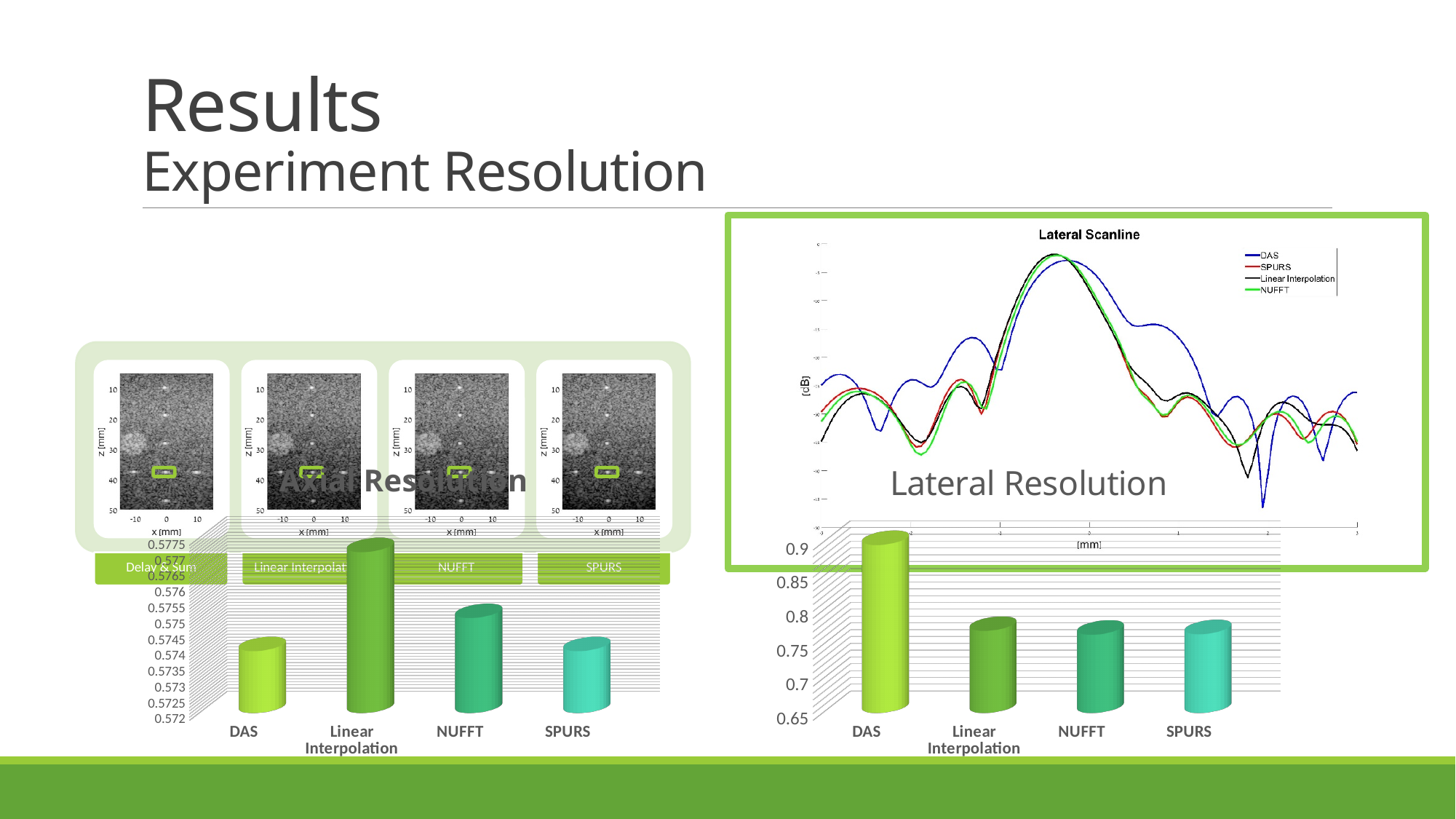
What kind of chart is the Lateral Resolution chart? Bar chart On the Axial Resolution chart, is the value for DAS greater or less than 0.575? less On the Axial Resolution chart, which category has the highest bar? Linear Interpolation On the Lateral Resolution chart, which is larger, the value for DAS or the value for NUFFT? DAS How many series does the legend of the Lateral Scanline chart list? 4 On the Axial Resolution chart, how many categories are plotted? 4 On the Lateral Resolution chart, is the value for Linear Interpolation greater or less than 0.85? less On the Axial Resolution chart, is the value for Linear Interpolation greater or less than 0.576? greater On the Lateral Resolution chart, which category has the highest bar? DAS On the Axial Resolution chart, which is larger, the value for Linear Interpolation or the value for SPURS? Linear Interpolation On the Lateral Resolution chart, how many categories are plotted? 4